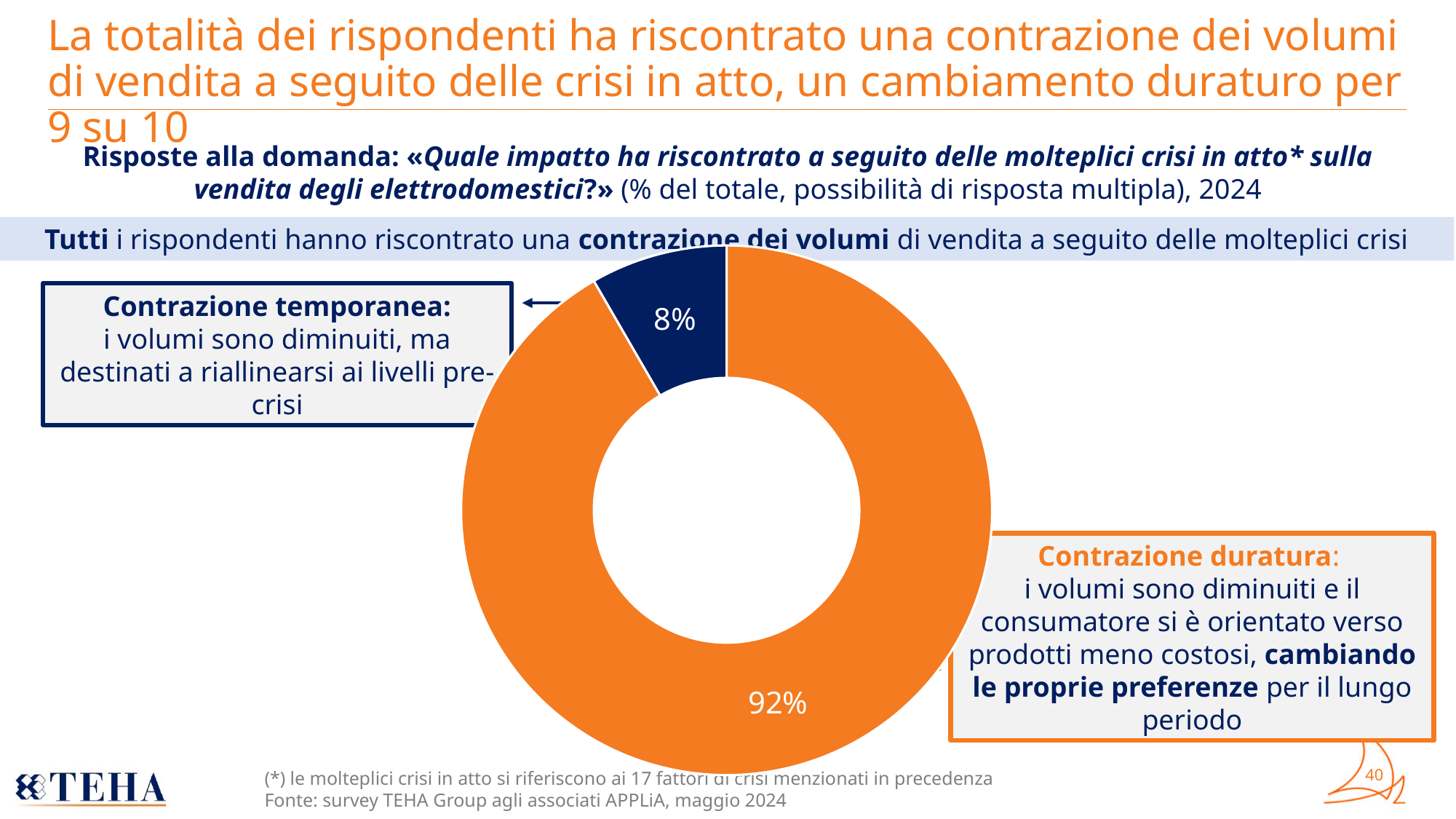
How many segments does the chart have? 2 What is the difference in percentage points between the 'Contrazione duratura' and 'Contrazione temporanea' shares? 84 What kind of chart is shown on the slide? Pie chart (doughnut) Which response has the smallest share in the chart? Contrazione temporanea What share of respondents reported a 'Contrazione duratura' (lasting contraction)? 92% Which is larger: the share for 'Contrazione duratura' or for 'Contrazione temporanea'? Contrazione duratura What share of respondents reported a 'Contrazione temporanea' (temporary contraction)? 8% What colour is the segment representing 'Contrazione temporanea'? Dark blue What is the total of the two segments shown in the chart? 100% What colour is the segment representing 'Contrazione duratura'? Orange Which response has the largest share in the chart? Contrazione duratura